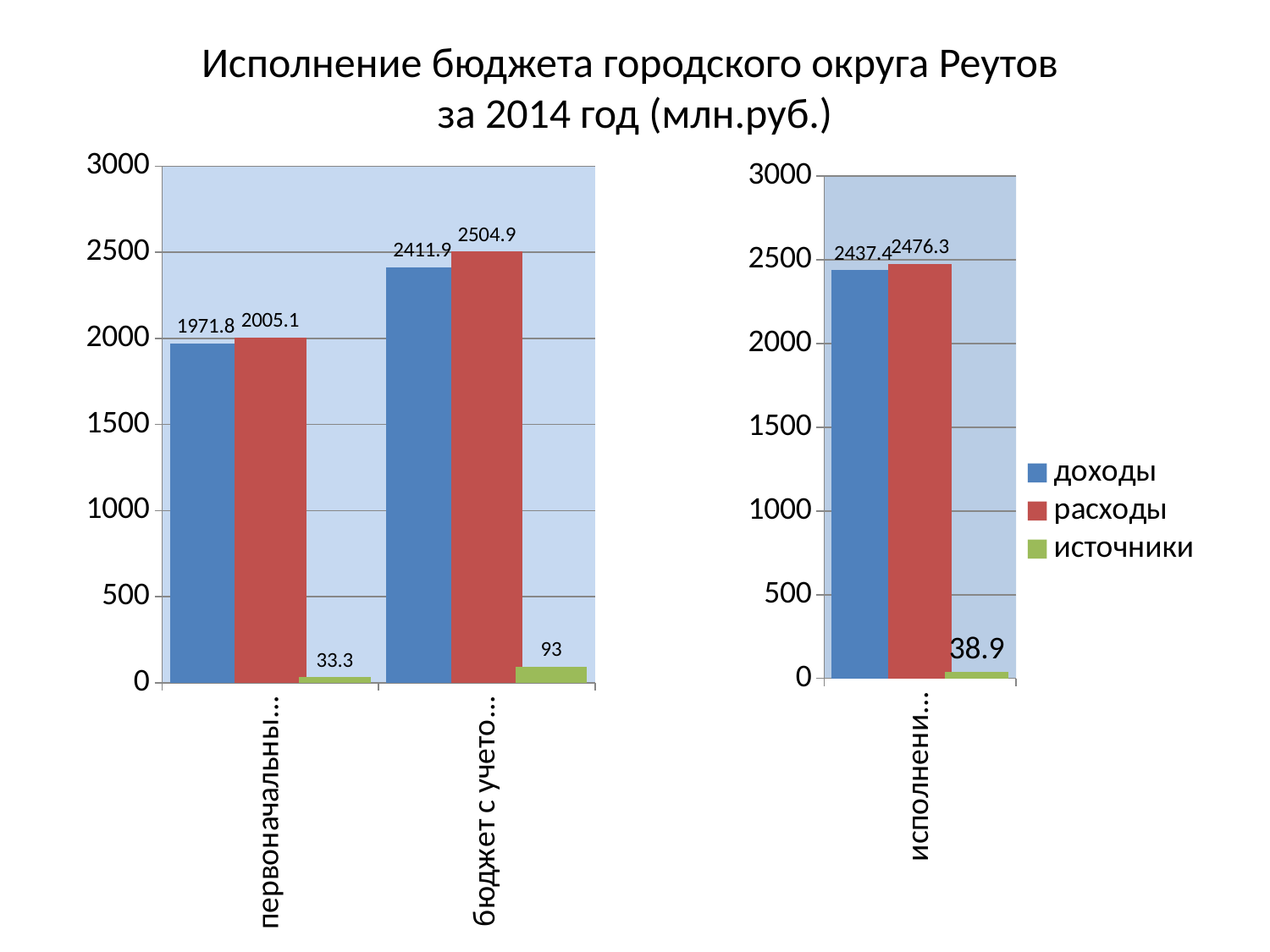
In the left chart, what is the highest plotted value? 2504.9 In the right chart, what is the difference between расходы (2476.3) and доходы (2437.4)? 38.9 In the left chart, what is the difference between расходы and доходы in the first (left) category group? 33.3 How many series does the legend list? 3 What kind of chart is the chart on the left of the slide? bar chart In the left chart, what is the value of доходы for the first (left) category group? 1971.8 In the left chart, is the источники value larger in the first category group or the second category group? second category group In the right chart, is the value for доходы greater or less than 2000? greater In the left chart, what is the value of расходы for the second (right) category group? 2504.9 What colour represents the расходы series in the legend? red How many category groups does the left chart show? 2 In the right chart, what is the value of источники? 38.9